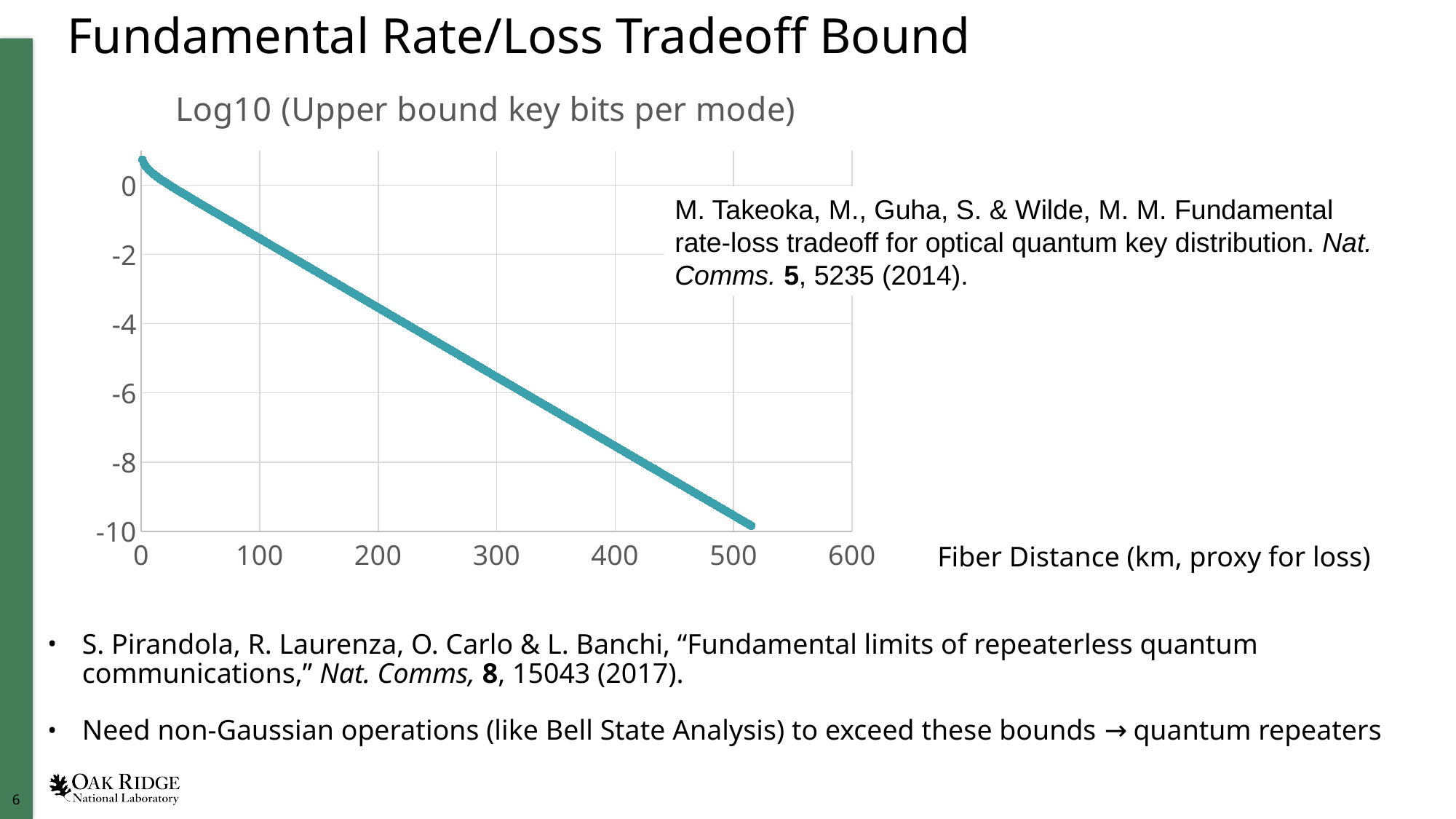
Does the plotted value rise or fall as fiber distance increases? fall Is the value at 100 km larger or smaller than the value at 400 km? larger Is the value at a fiber distance of 0 km greater or less than 0? greater What is the label of the vertical axis of the chart? Log10 (Upper bound key bits per mode) Is the value at a fiber distance of 400 km greater or less than -6? less Is the value at a fiber distance of 100 km greater or less than -2? greater What is the label of the horizontal axis of the chart? Fiber Distance (km, proxy for loss) How many data series are plotted on the chart? 1 What kind of chart is shown on the slide? line chart